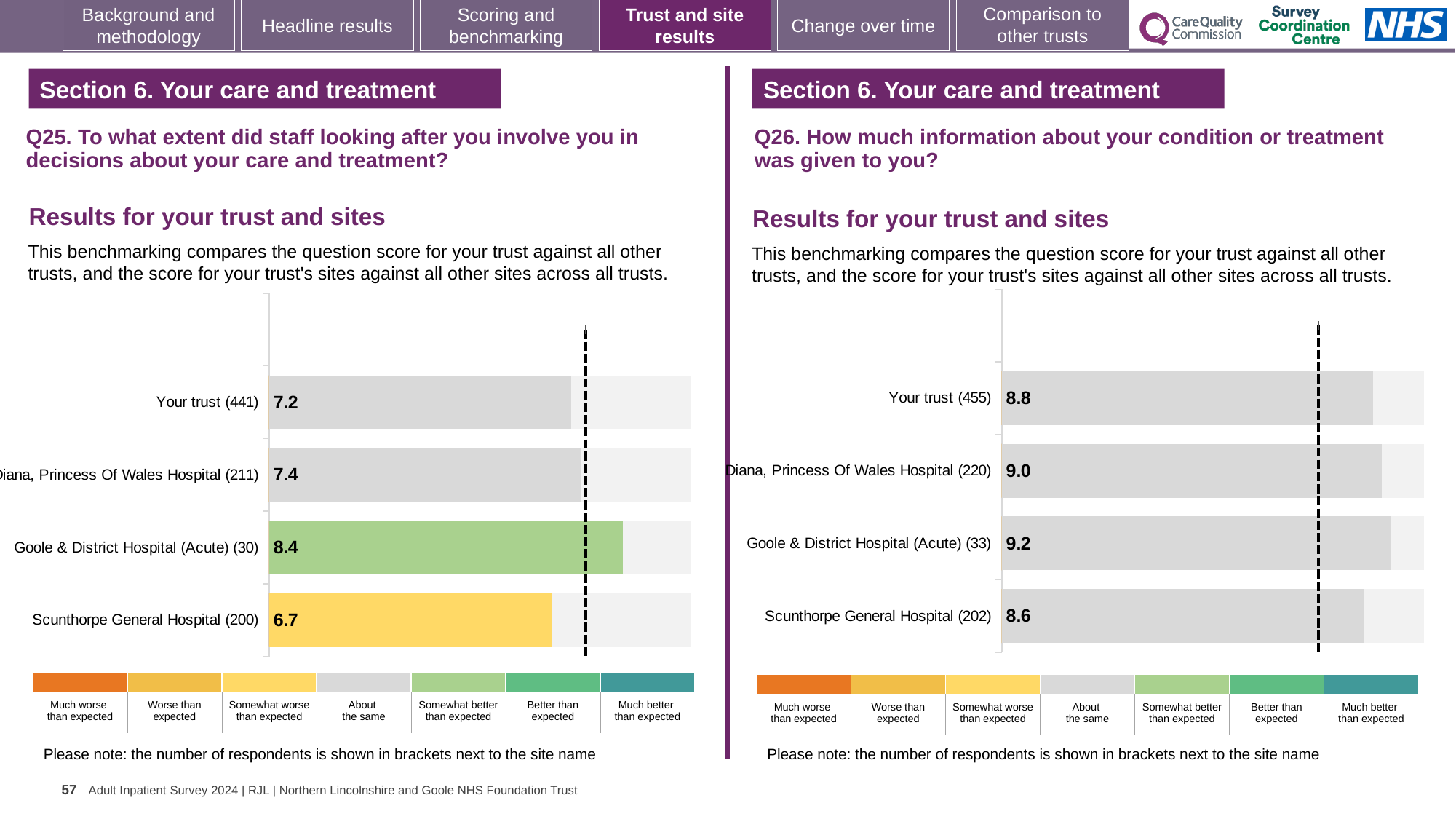
In the Q26 chart on the right, how many respondents are shown in brackets for Your trust? 455 In the Q25 chart on the left, which site has the lowest score? Scunthorpe General Hospital In the Q25 chart on the left, how many bars are plotted? 4 In the Q26 chart on the right, which site has the highest score? Goole & District Hospital (Acute) In the Q25 chart on the left, what colour is the bar for Scunthorpe General Hospital? Yellow In the Q26 chart on the right, what is the score for Diana, Princess Of Wales Hospital? 9.0 In the Q26 chart on the right, which is larger: the score for Your trust or the score for Scunthorpe General Hospital? Your trust In the Q25 chart on the left, what is the score for Goole & District Hospital (Acute)? 8.4 What type of chart is used for the Q26 results on the right? Bar chart In the Q25 chart on the left, what is the score for Your trust? 7.2 In the Q25 chart on the left, what is the difference between the scores for Goole & District Hospital (Acute) and Scunthorpe General Hospital? 1.7 In the Q26 chart on the right, what is the difference between the scores for Goole & District Hospital (Acute) and Your trust? 0.4